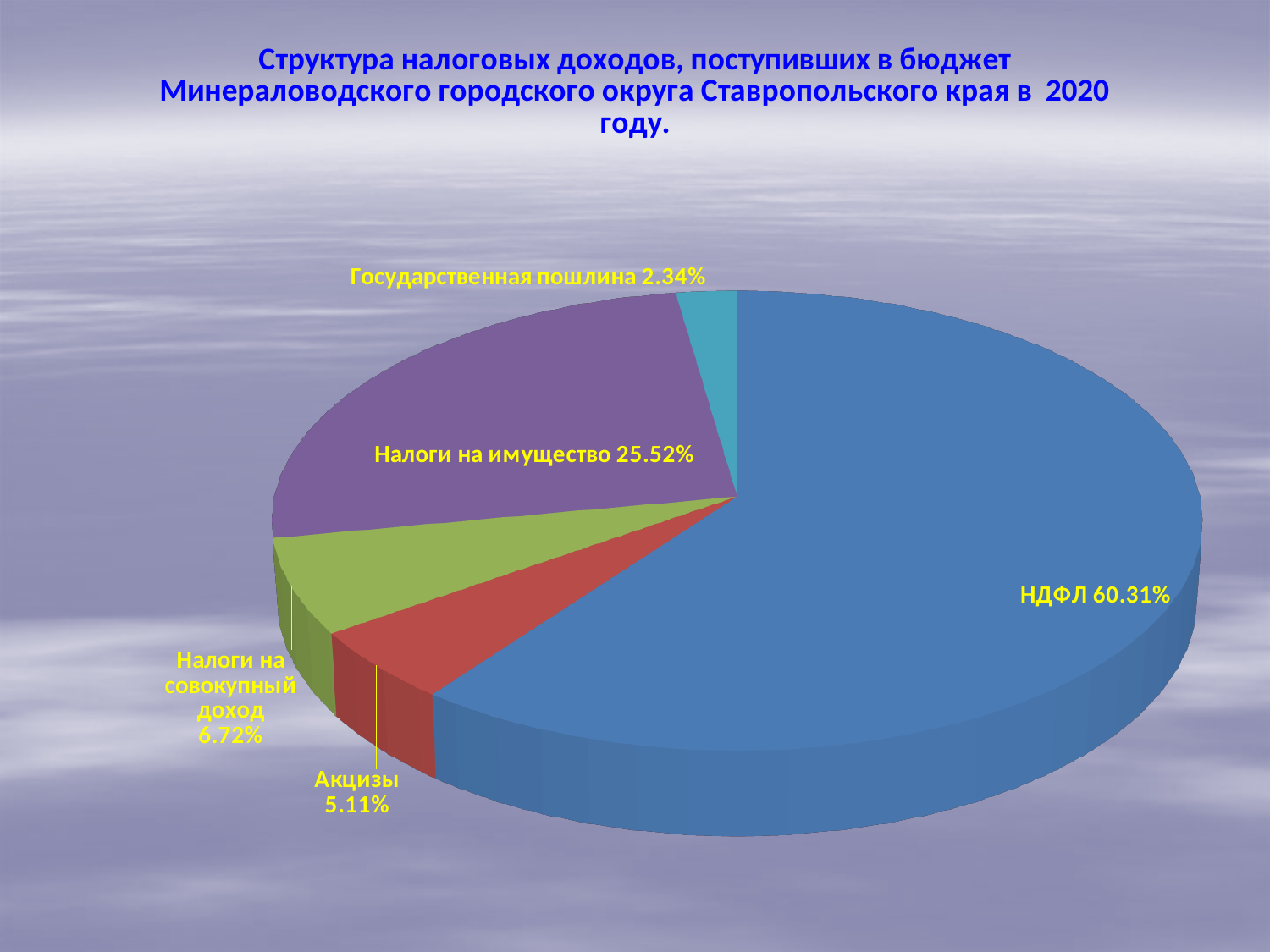
What is the value shown for Акцизы? 5.11% What kind of chart is shown on the slide? Pie chart What is the value shown for Государственная пошлина? 2.34% Which category has the smallest slice of the pie? Государственная пошлина What is the value shown for Налоги на совокупный доход? 6.72% What share of the pie does НДФЛ account for? 60.31% Which is larger, the share of Налоги на совокупный доход or the share of Акцизы? Налоги на совокупный доход What is the difference between the shares of НДФЛ and Налоги на имущество? 34.79% What is the value shown for Налоги на имущество? 25.52% Which category has the largest slice of the pie? НДФЛ How many categories are shown in the pie chart? 5 What colour is the НДФЛ slice? Blue